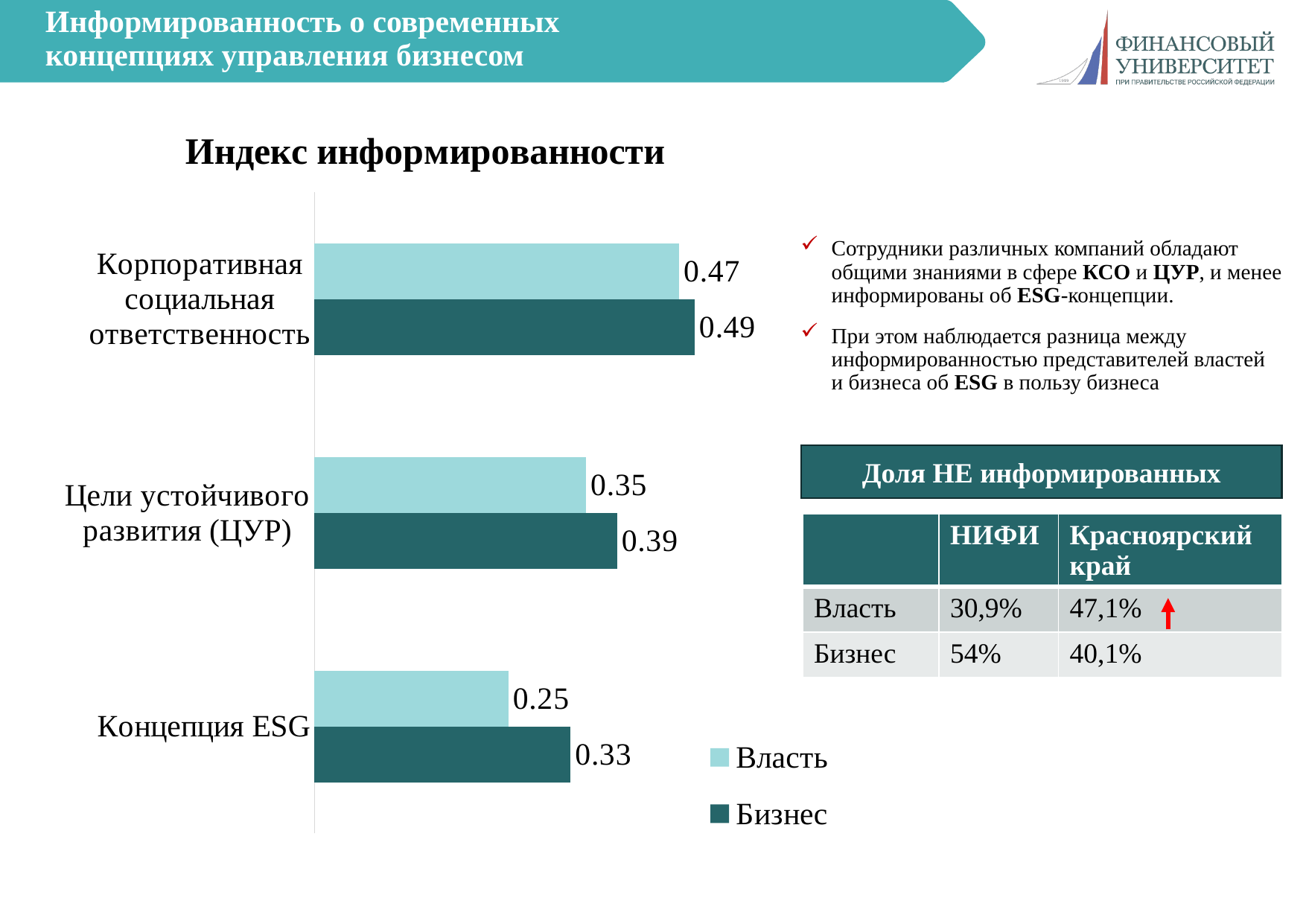
How many series does the legend list? 2 Which category has the lowest value for Власть? Концепция ESG How many categories are shown in the chart? 3 What kind of chart is shown on the slide? Bar chart What is the value for Власть for Концепция ESG? 0.25 Which category has the highest value for Бизнес? Корпоративная социальная ответственность What is the value for Бизнес for Корпоративная социальная ответственность? 0.49 What is the value for Бизнес for Концепция ESG? 0.33 What is the difference between the Бизнес and Власть values for Концепция ESG? 0.08 What is the difference between the Бизнес and Власть values for Цели устойчивого развития (ЦУР)? 0.04 Which is larger for Корпоративная социальная ответственность: the Власть value or the Бизнес value? Бизнес What is the value for Власть for Цели устойчивого развития (ЦУР)? 0.35